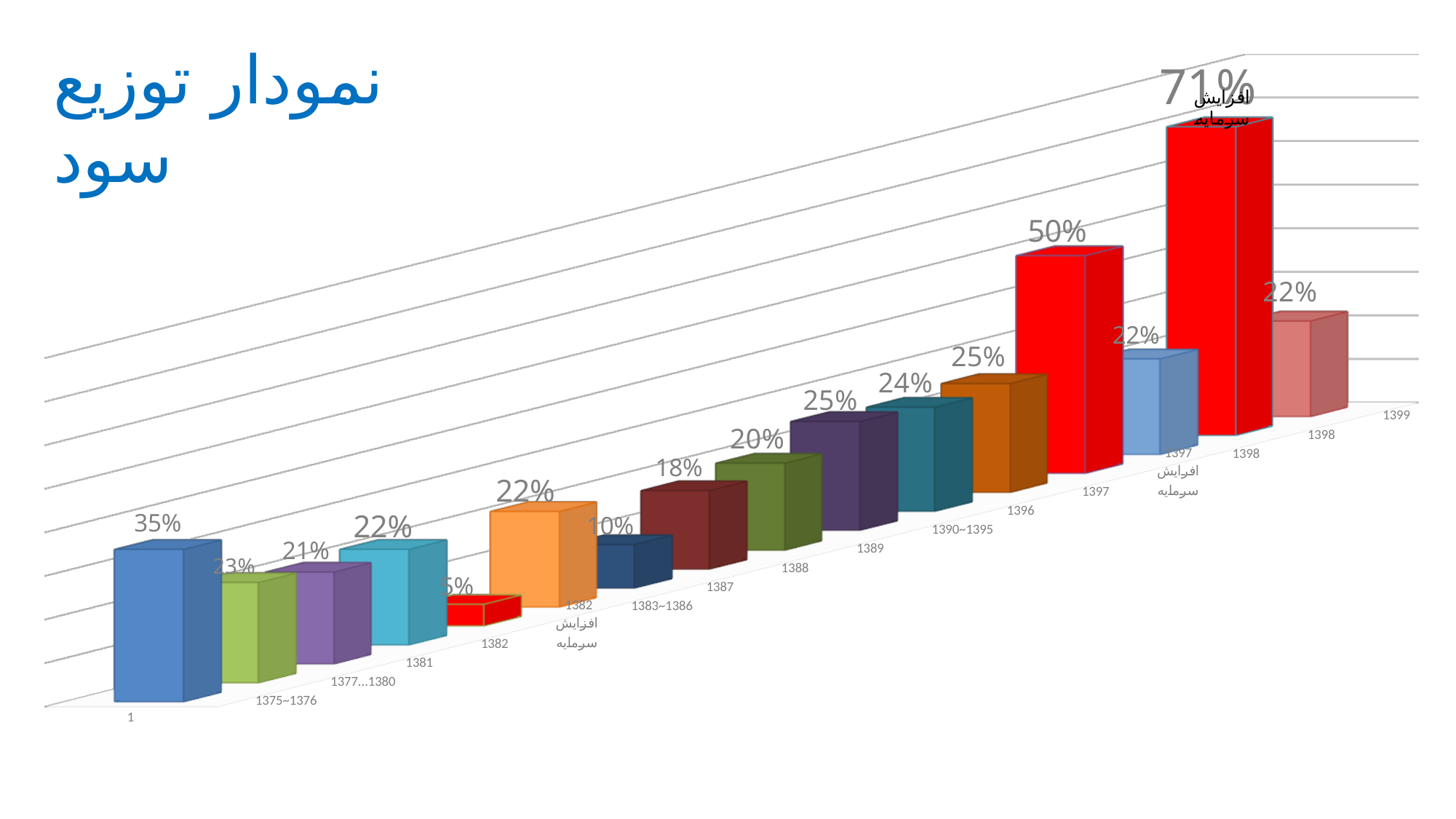
Which category has the highest value? 1398 What is the value for 1397? 25% What is the value for 1387? 10% What kind of chart is shown on the slide? Bar chart What is the value for 1383~1386? 22% What is the value for the first category, labelled 1? 35% Which category has the lowest value? 1382 افزایش سرمایه Which is larger, the value for 1389 or the value for 1388? 1389 How many categories are shown on the x axis? 16 What is the title of the slide? نمودار توزیع سود